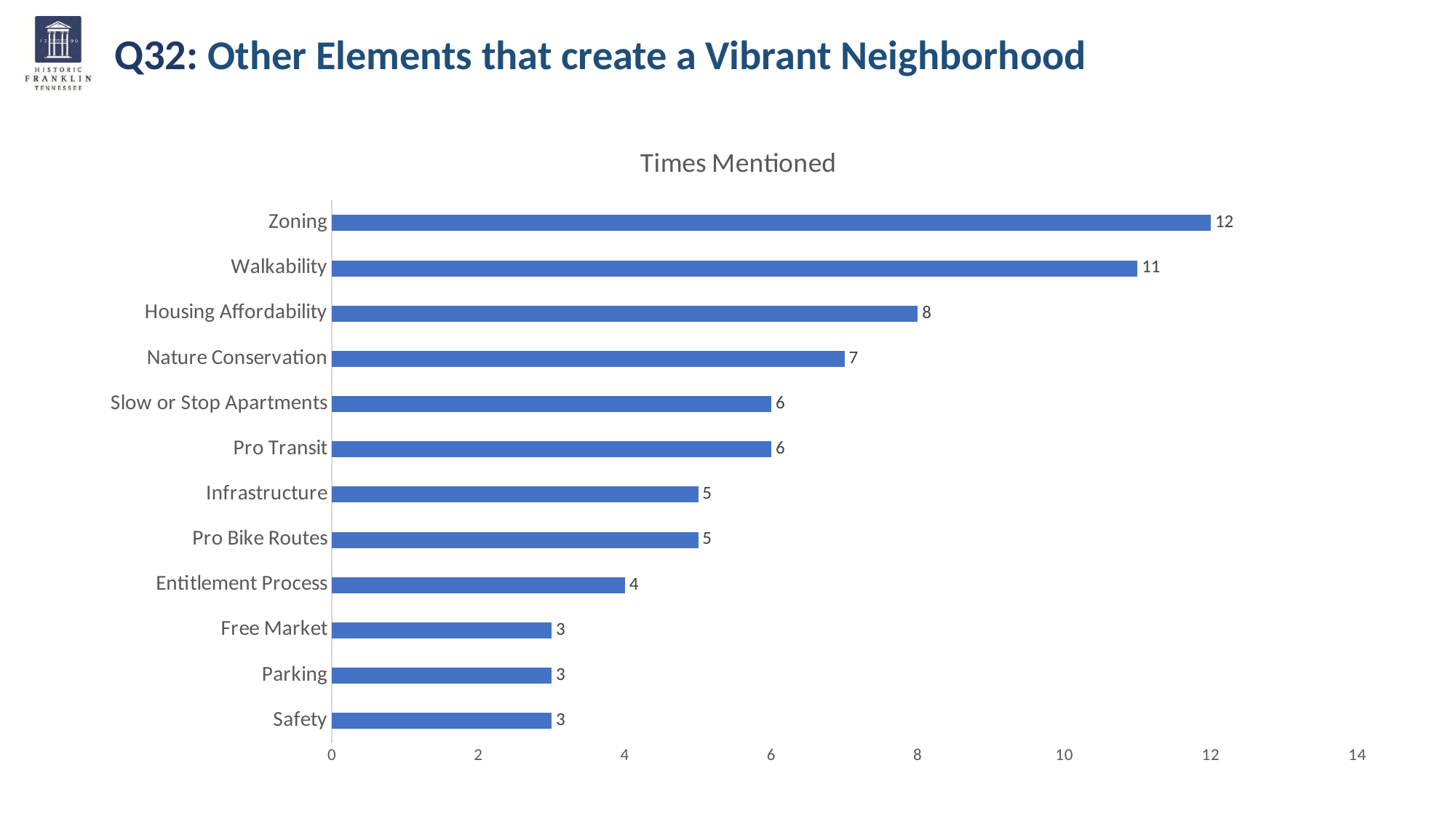
What is the value for Entitlement Process? 4 What is the difference between the values for Housing Affordability and Safety? 5 Is the value for Walkability greater or less than 10? greater What is the value for Housing Affordability? 8 Which category has the highest number of times mentioned? Zoning What kind of chart is shown on the slide? bar chart How many categories are shown in the chart? 12 What is the value for Infrastructure? 5 What is the title of the chart? Times Mentioned How many times was Zoning mentioned? 12 Which has a larger value, Nature Conservation or Pro Transit? Nature Conservation What is the difference between the values for Zoning and Walkability? 1